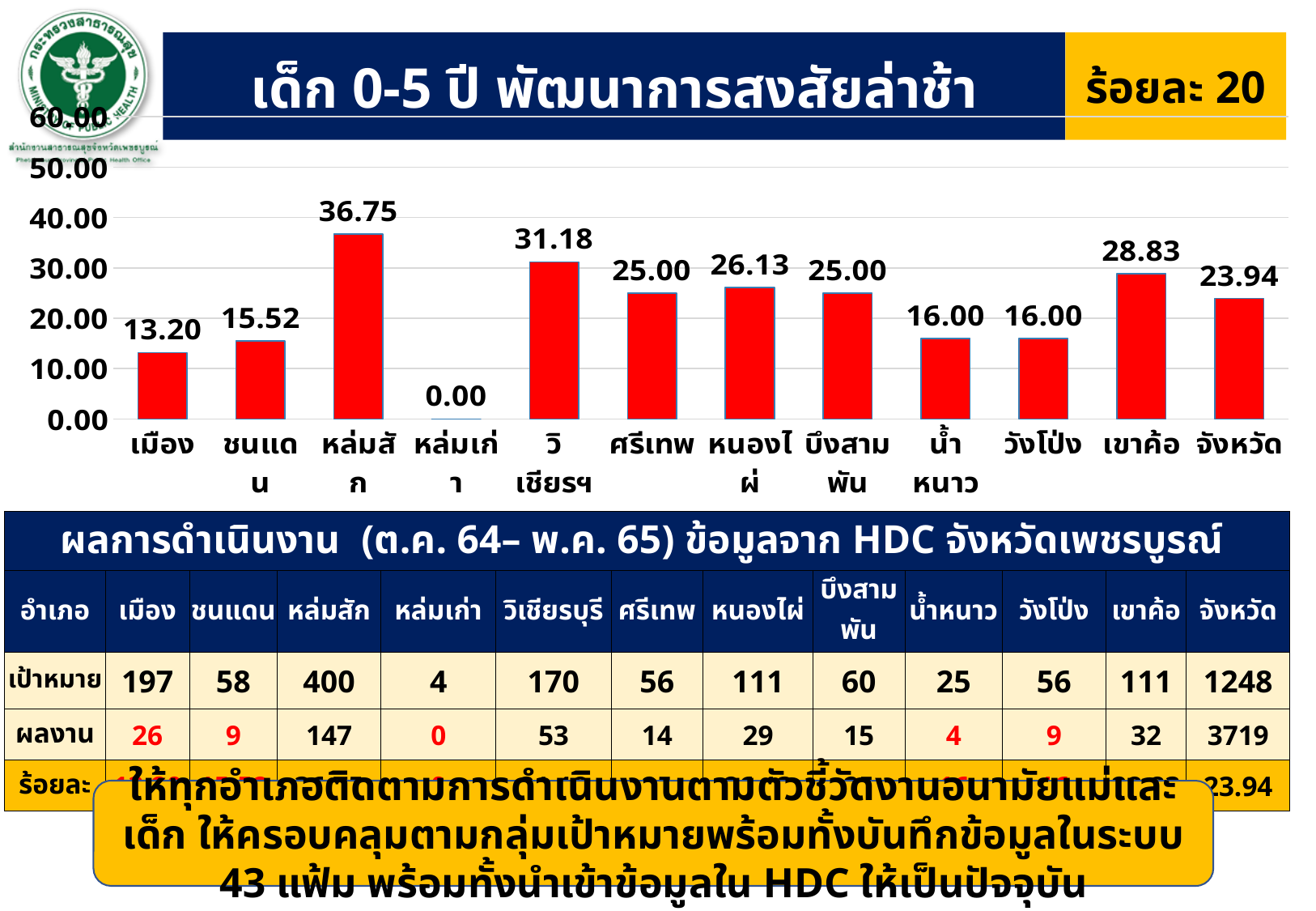
How many categories are shown on the x axis of the bar chart? 12 What is the difference between the values for หล่มสัก and วิเชียรฯ? 5.57 What kind of chart is shown on the slide? bar chart What is the value for หล่มสัก in the bar chart? 36.75 What is the value for จังหวัด in the bar chart? 23.94 Which category has the lowest value in the bar chart? หล่มเก่า Which is larger, the value for เขาค้อ or the value for หนองไผ่? เขาค้อ What is the value for เมือง in the bar chart? 13.20 What colour are the bars in the chart? red Which category has the highest value in the bar chart? หล่มสัก Is the value for ชนแดน greater or less than 20.00? less What is the title of the chart? เด็ก 0-5 ปี พัฒนาการสงสัยล่าช้า